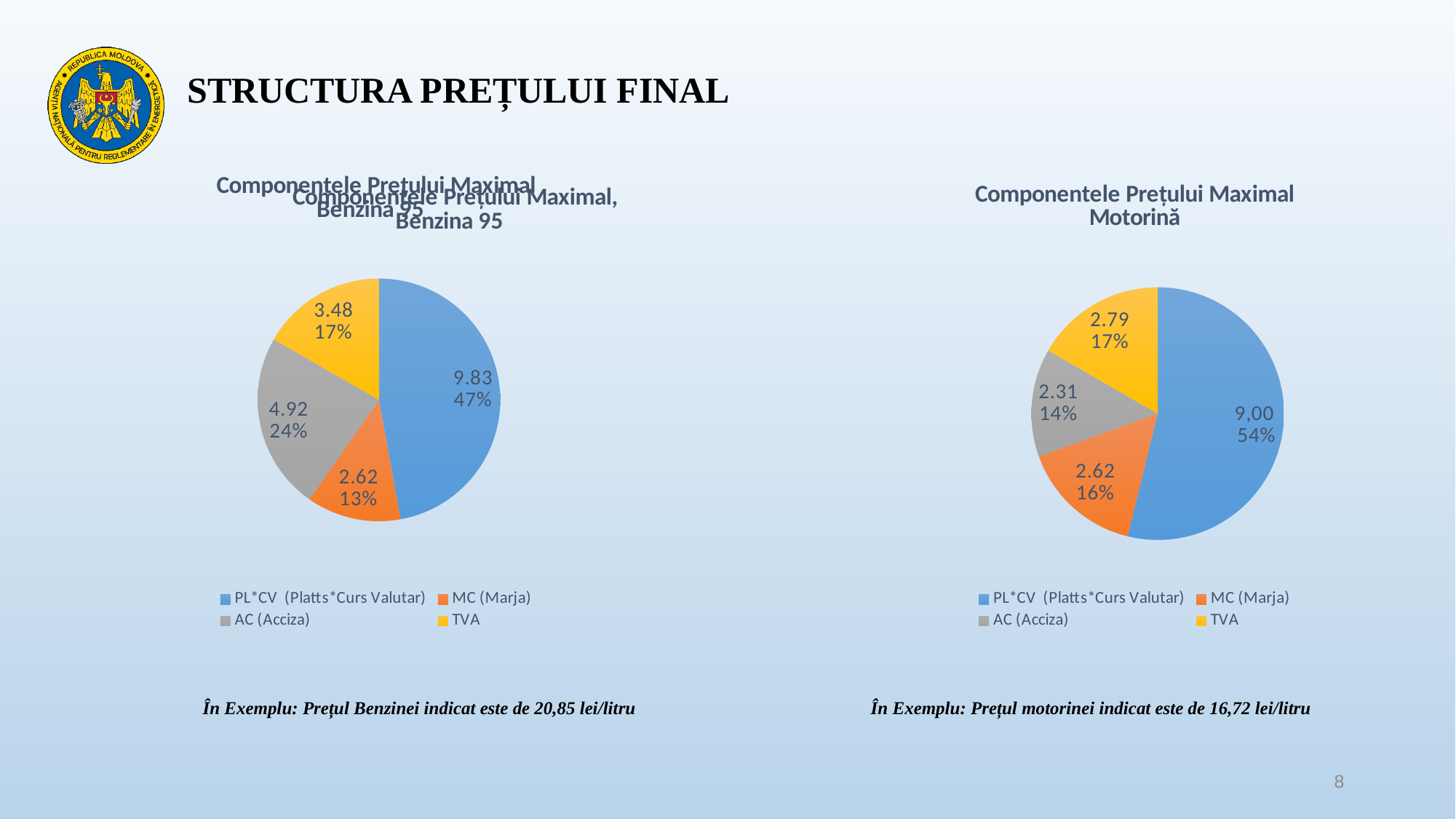
In the Benzina 95 pie chart on the left, what is the difference between the AC (Acciza) value and the MC (Marja) value? 2.30 What type of chart is used for the Benzina 95 chart on the left? Pie chart In the Benzina 95 pie chart on the left, which component has the smallest share? MC (Marja) In the Benzina 95 pie chart on the left, what value is shown for TVA? 3.48 In the Benzina 95 pie chart on the left, what value is shown for PL*CV (Platts*Curs Valutar)? 9.83 In the Motorină pie chart on the right, what percentage share does MC (Marja) have? 16% In the Motorină pie chart on the right, which is larger: the value for TVA or the value for AC (Acciza)? TVA In the Benzina 95 pie chart on the left, what percentage share does AC (Acciza) have? 24% In the Motorină pie chart on the right, what value is shown for PL*CV (Platts*Curs Valutar)? 9,00 In the Motorină pie chart on the right, what value is shown for AC (Acciza)? 2.31 In the Motorină pie chart on the right, which component has the largest share? PL*CV (Platts*Curs Valutar) How many slices does the Motorină pie chart on the right have? 4